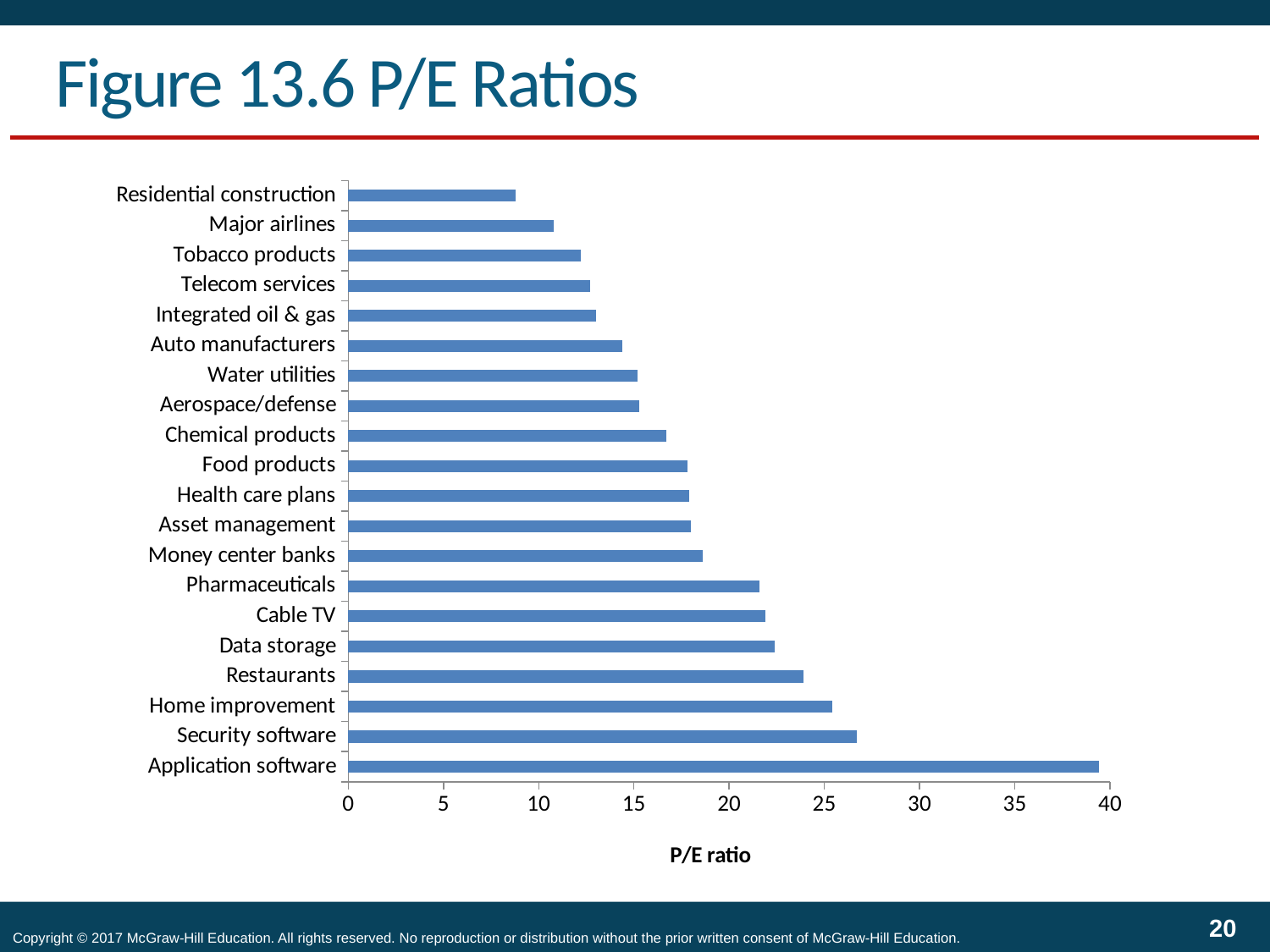
Is the P/E ratio for Chemical products greater or less than 15? greater Which has a higher P/E ratio, Cable TV or Money center banks? Cable TV Is the P/E ratio for Residential construction greater or less than 10? less Is the P/E ratio for Security software greater or less than 25? greater What kind of chart is shown on the slide? bar chart What is the label on the horizontal axis of the chart? P/E ratio Which industry has the highest P/E ratio? Application software Which industry has the lowest P/E ratio? Residential construction Which has a higher P/E ratio, Security software or Restaurants? Security software How many industries are plotted in the chart? 20